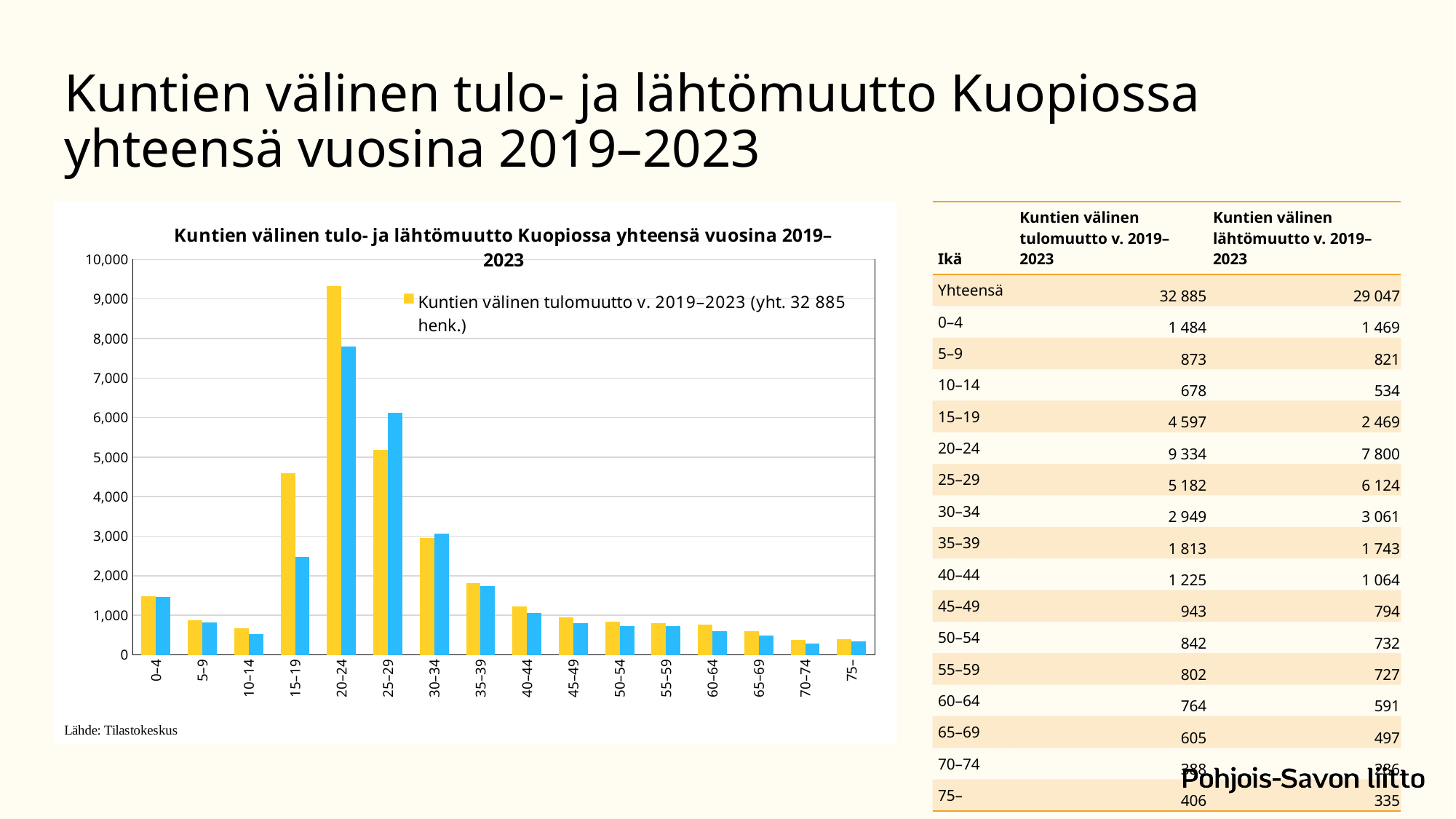
What is the value of Kuntien välinen tulomuutto v. 2019–2023 for the 20–24 age group? 9 334 What colour are the bars for Kuntien välinen tulomuutto in the chart? yellow What kind of chart is shown on the slide? bar chart How many age groups are shown on the x axis of the chart? 16 For the 25–29 age group, which is larger: tulomuutto or lähtömuutto? lähtömuutto What is the difference between tulomuutto and lähtömuutto for the 20–24 age group? 1 534 Which age group has the highest value for Kuntien välinen tulomuutto (yellow bars)? 20–24 Is the tulomuutto value for the 15–19 age group greater or less than 4,000? greater What is the value of Kuntien välinen lähtömuutto v. 2019–2023 for the 25–29 age group? 6 124 Is the lähtömuutto value for the 10–14 age group greater or less than 1,000? less According to the legend, what is the total number of people for Kuntien välinen tulomuutto v. 2019–2023? 32 885 For the 15–19 age group, which is larger: tulomuutto or lähtömuutto? tulomuutto